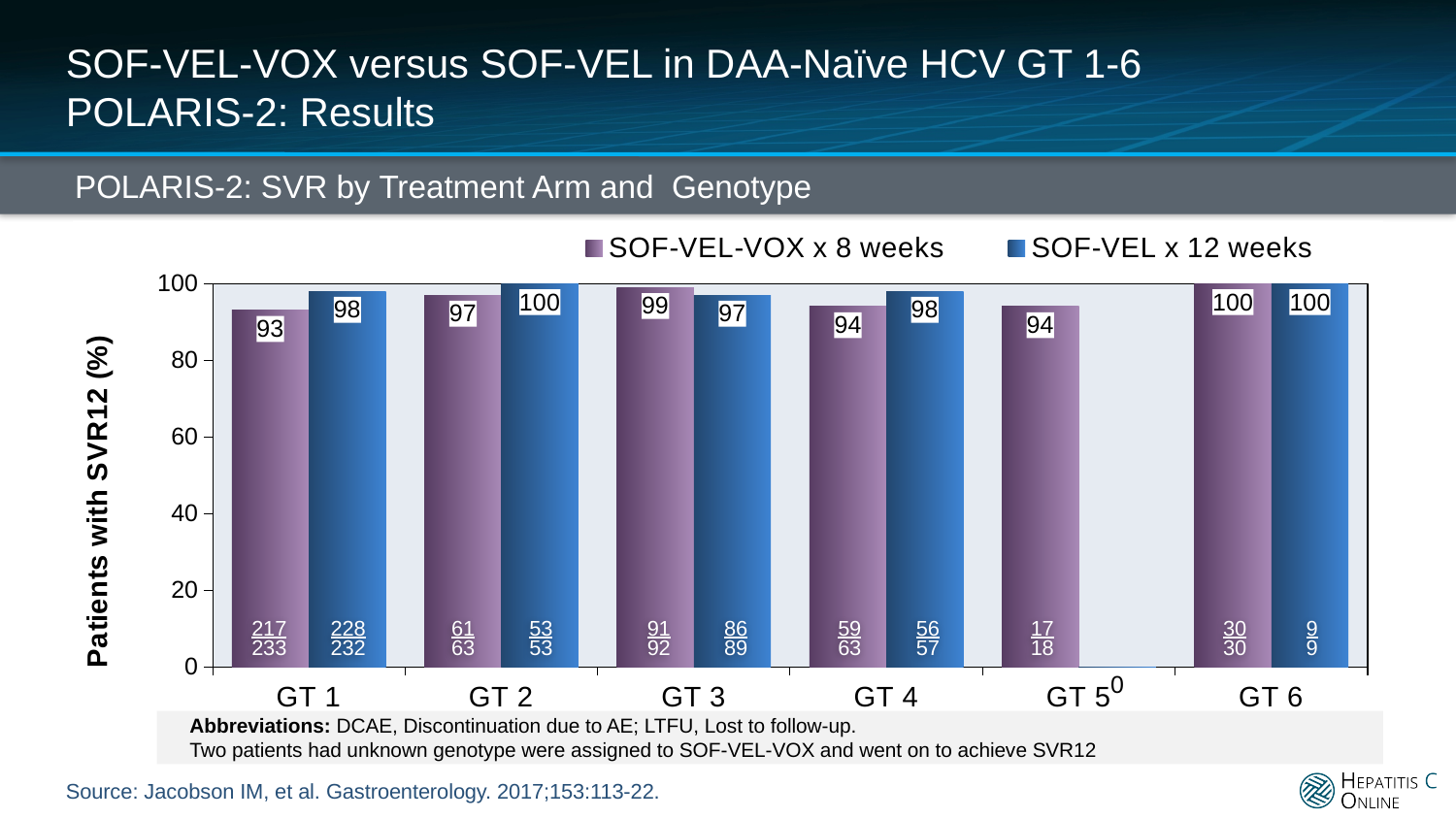
What is the label of the y axis? Patients with SVR12 (%) What is the SVR12 rate for SOF-VEL x 12 weeks in GT 2? 100 What is the SVR12 rate for SOF-VEL x 12 weeks in GT 4? 98 What kind of chart is shown on the slide? Bar chart What is the SVR12 rate for SOF-VEL-VOX x 8 weeks in GT 5? 94 How many series does the legend list? 2 Which genotype has the lowest SVR12 rate for SOF-VEL-VOX x 8 weeks? GT 1 What is the difference between the SOF-VEL x 12 weeks and SOF-VEL-VOX x 8 weeks SVR12 rates in GT 1? 5 In GT 3, which treatment arm has the higher SVR12 rate? SOF-VEL-VOX x 8 weeks Which genotype has the highest SVR12 rate for SOF-VEL-VOX x 8 weeks? GT 6 How many genotype categories are shown on the x axis? 6 What is the SVR12 rate for SOF-VEL-VOX x 8 weeks in GT 1? 93